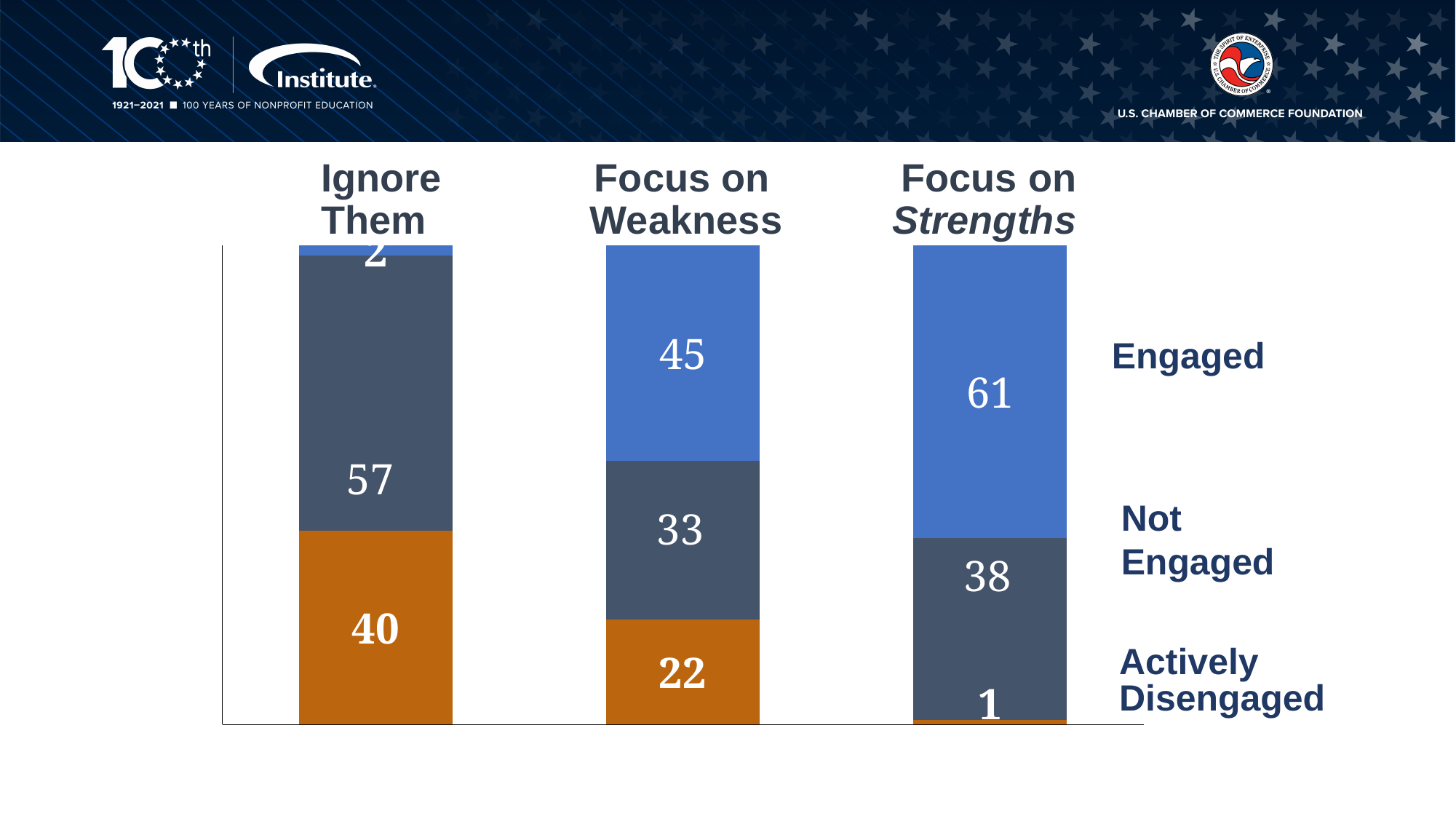
What is the Engaged value for Focus on Strengths? 61 How many series does the legend list? 3 What is the Actively Disengaged value for Ignore Them? 40 What is the difference between the Engaged values for Focus on Strengths and Focus on Weakness? 16 What is the Not Engaged value for Focus on Weakness? 33 What is the Engaged value for Ignore Them? 2 What is the total of the stacked bar for Focus on Weakness? 100 How many categories are shown on the x axis? 3 Which is larger: the Not Engaged value for Ignore Them or for Focus on Strengths? Ignore Them What kind of chart is shown? Stacked bar chart Which category has the lowest Actively Disengaged value? Focus on Strengths Which category has the highest Engaged value? Focus on Strengths